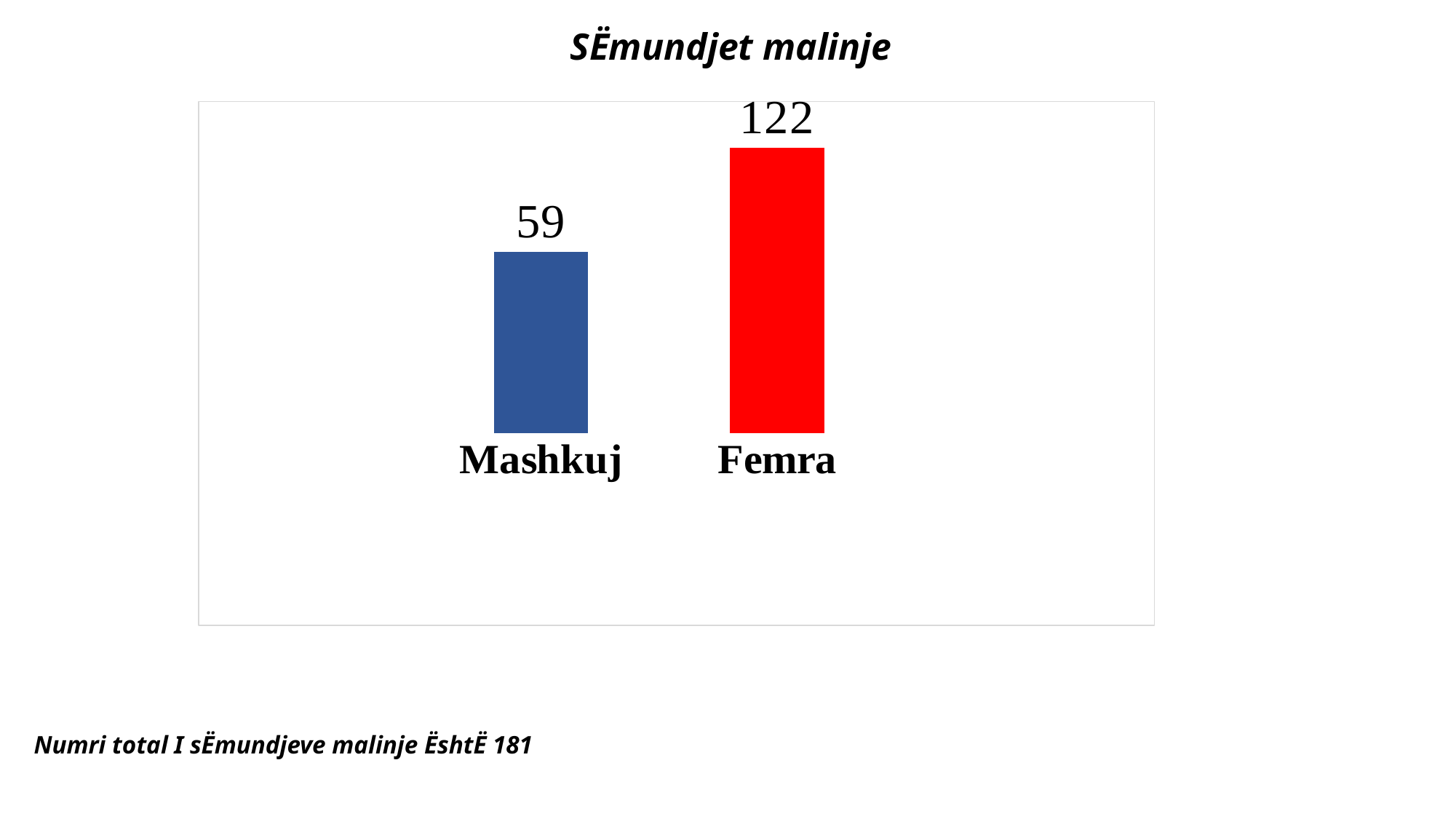
What is the title of the chart? SËmundjet malinje What is the value for Femra? 122 What is the total of the two values shown in the chart? 181 What is the difference between the values for Femra and Mashkuj? 63 Which category has the highest value? Femra What is the value for Mashkuj? 59 Which category has the lowest value? Mashkuj How many categories are shown in the chart? 2 What kind of chart is shown on the slide? Bar chart Which is larger, the value for Mashkuj or the value for Femra? Femra What colour is the bar for Femra? Red